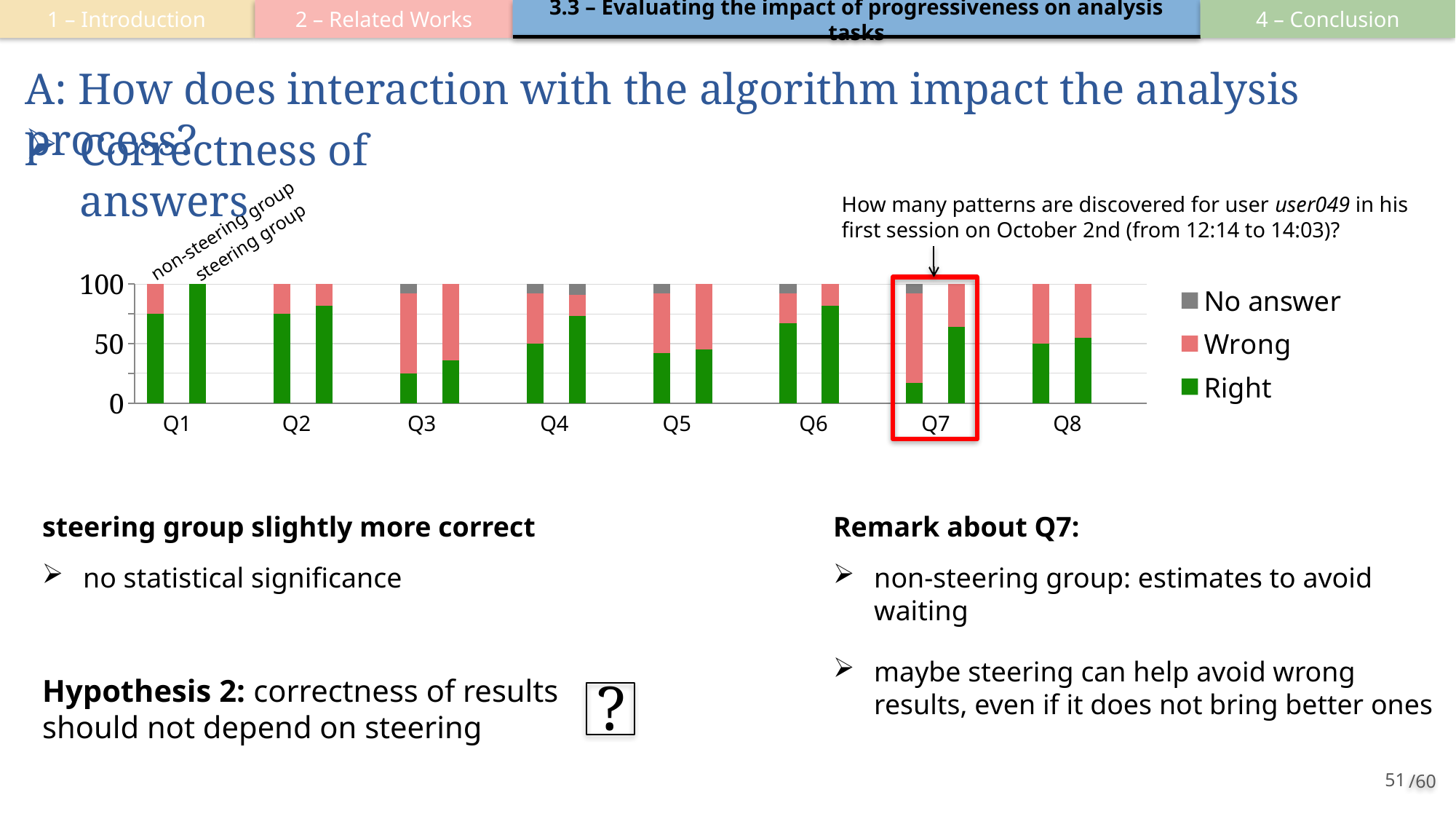
How many series does the chart legend list? 3 What are the three legend entries of the chart? No answer, Wrong, Right Is the Right value for the non-steering group in Q1 greater or less than 50? greater In Q7, which group has the larger Right value, the non-steering group or the steering group? steering group Which question category is highlighted with a red box on the chart? Q7 What kind of chart is shown on the slide? stacked bar chart How many question categories (Q1 to Q8) are shown on the x axis? 8 Is the Right value for the non-steering group in Q3 greater or less than 50? less For the steering group, which question has the highest Right value? Q1 Is the Right value for the non-steering group in Q7 greater or less than 50? less What is the Right value for the steering group bar in Q1? 100